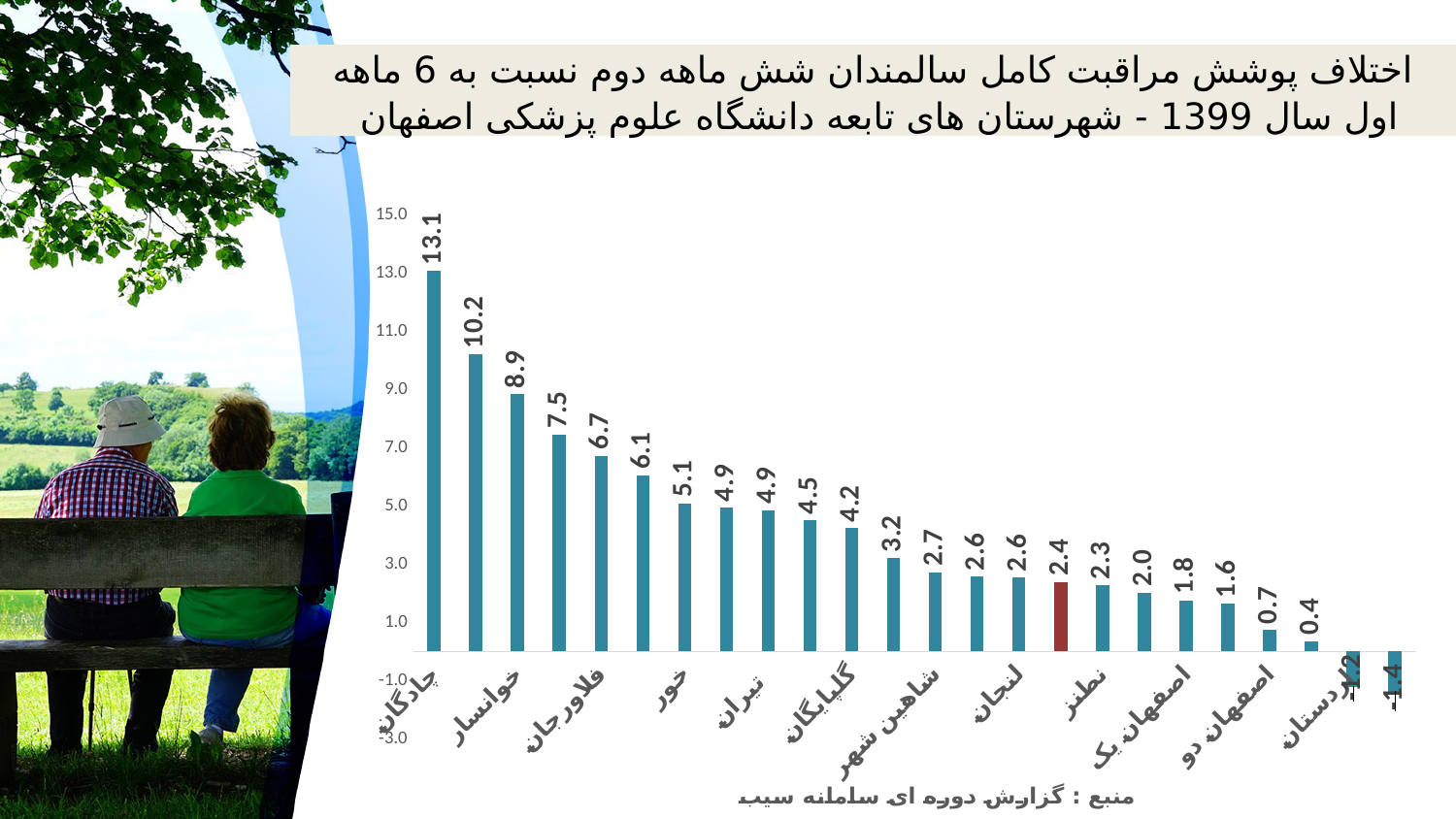
Which is larger, the value for خور or the value for نطنز? خور Do the values rise or fall from left to right along the x axis? Fall What is the value for خوانسار? 8.9 What is the difference between the values for چادگان and خوانسار? 4.2 What is the value for خور? 5.1 Which category has the highest value? چادگان What is the value for اصفهان دو? 0.7 What is the value for فلاورجان? 6.7 What kind of chart is shown on the slide? Bar chart What is the value of the bar highlighted in red? 2.4 What is the value for نطنز? 2.3 What is the value for چادگان? 13.1